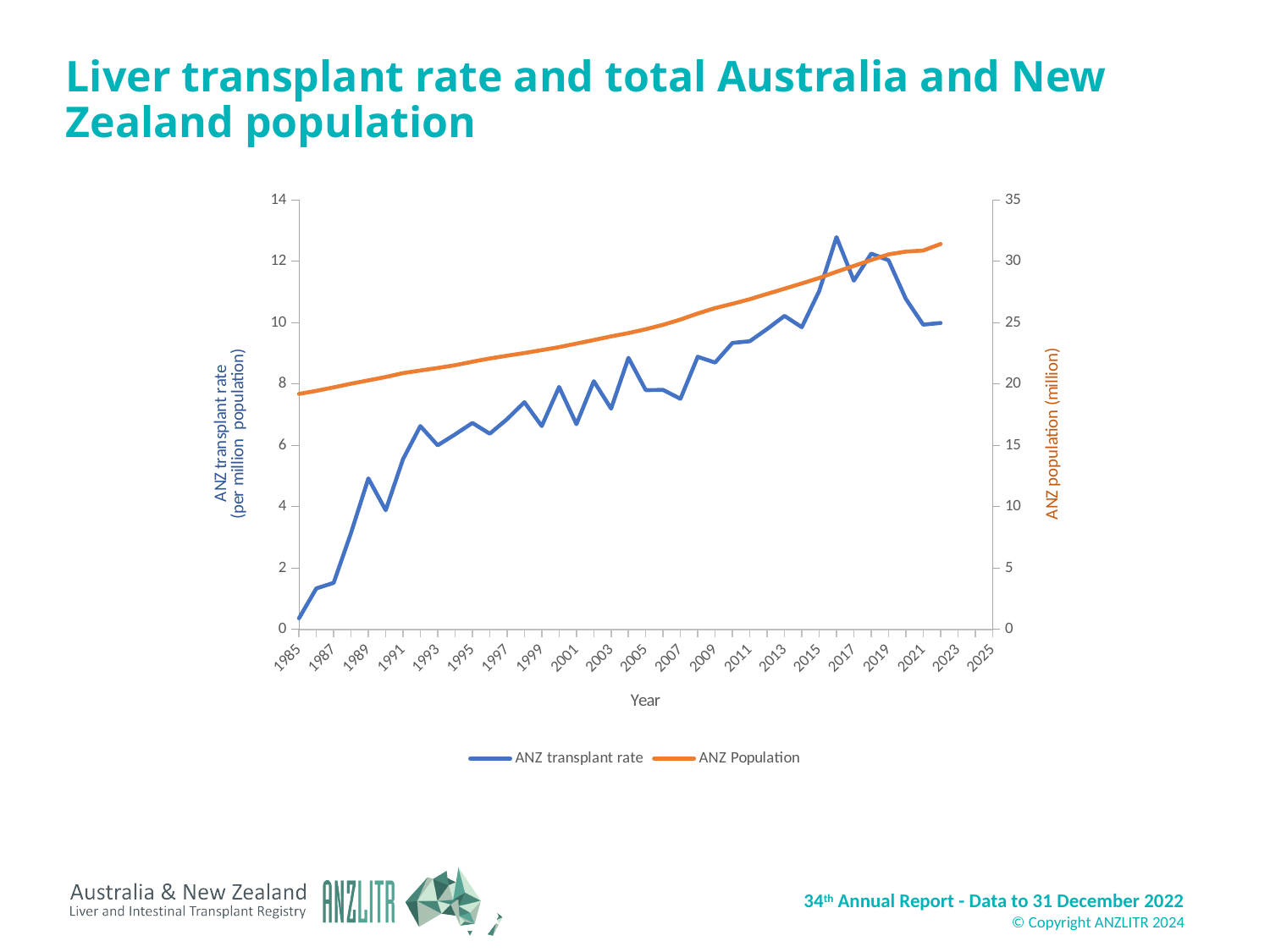
Which is larger, the ANZ transplant rate in 2022 or its peak around 2016? the peak around 2016 Is the ANZ transplant rate in 2022 greater or less than 8? greater Is the ANZ population in 1985 greater or less than 20 million? less Is the ANZ transplant rate in 1985 greater or less than 2? less Which is larger, the ANZ transplant rate in 1985 or in 2022? 2022 Does the ANZ population rise or fall from 1985 to 2022? rise What kind of chart is shown on the slide? line chart How many series does the legend list? 2 Which colour is used for the ANZ Population line? orange What is the label of the right-hand vertical axis? ANZ population (million)